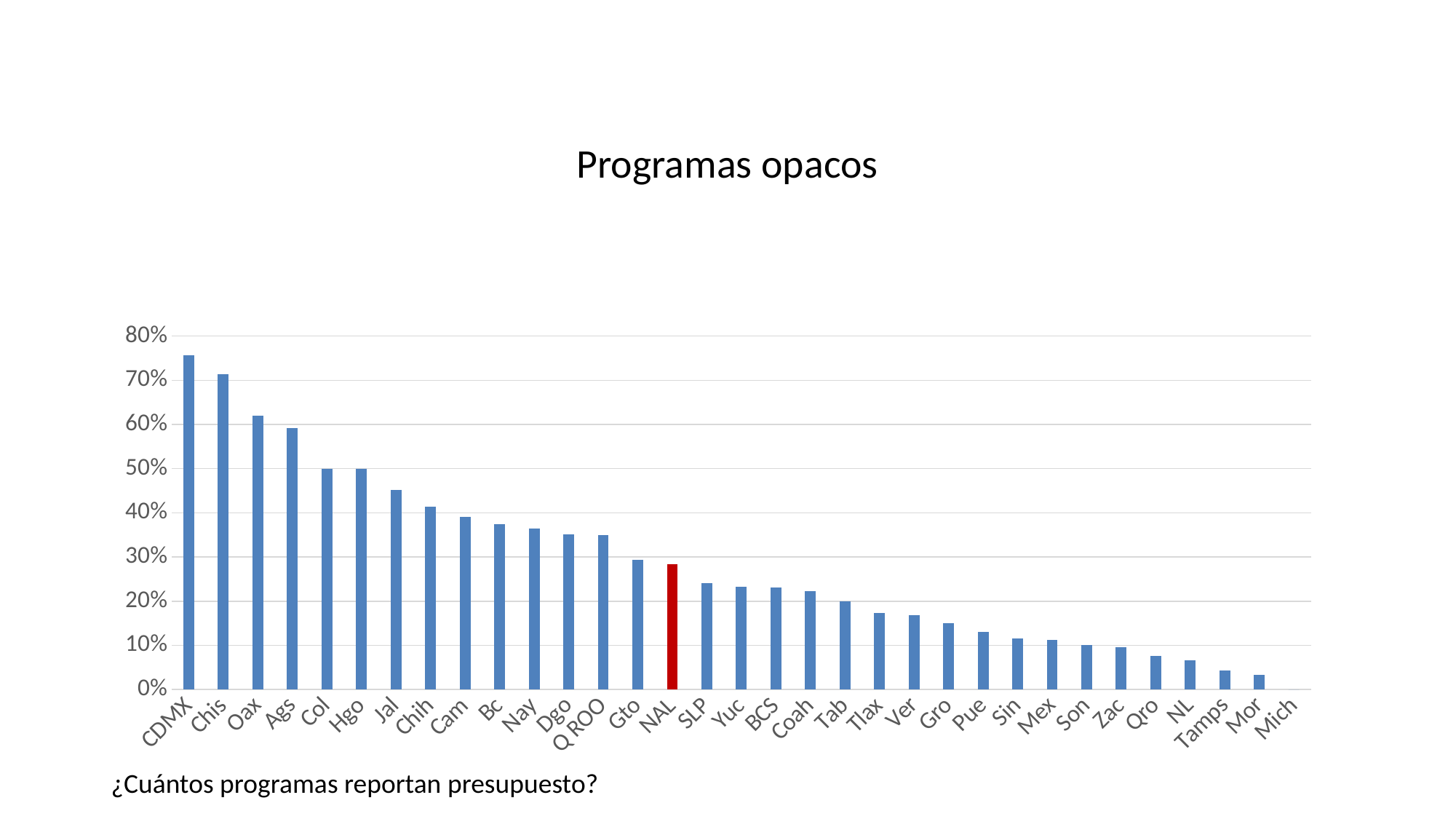
Do the values rise or fall moving from left to right along the x axis? Fall Which category's bar is coloured red instead of blue? NAL Which category has the highest value in the chart? CDMX Is the value for Gro greater or less than 20%? less Which is larger, the value for Pue or the value for Sin? Pue What kind of chart is shown on the slide? Bar chart Is the value for Jal greater or less than 40%? greater What is the title of the chart? Programas opacos How many categories are shown on the x axis? 33 Which is larger, the value for Chis or the value for Oax? Chis Is the value for Oax greater or less than 60%? greater